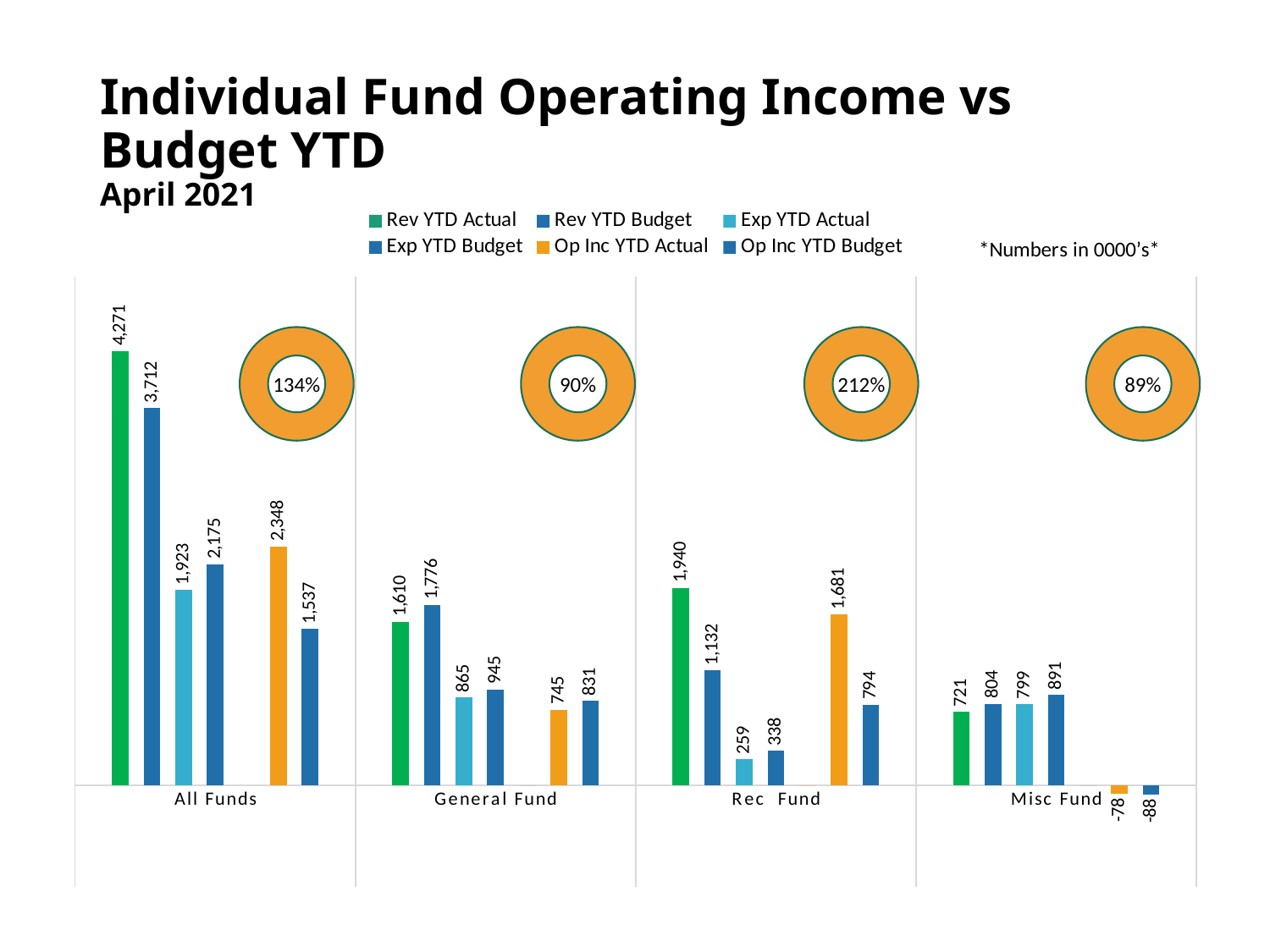
How many fund categories are shown on the x axis? 4 What is the Op Inc YTD Actual value for the Misc Fund? -78 Which category has the lowest Exp YTD Actual value? Rec Fund For the General Fund, which is larger: Rev YTD Actual or Rev YTD Budget? Rev YTD Budget What is the Rev YTD Actual value for All Funds? 4,271 What is the difference between Op Inc YTD Actual and Op Inc YTD Budget for the Rec Fund? 887 What is the Op Inc YTD Actual value for the Rec Fund? 1,681 What is the difference between Rev YTD Actual and Rev YTD Budget for All Funds? 559 Which category has the highest Rev YTD Actual value? All Funds How many series does the legend list? 6 What percentage is shown in the donut above the Rec Fund bars? 212% What is the Exp YTD Budget value for the General Fund? 945